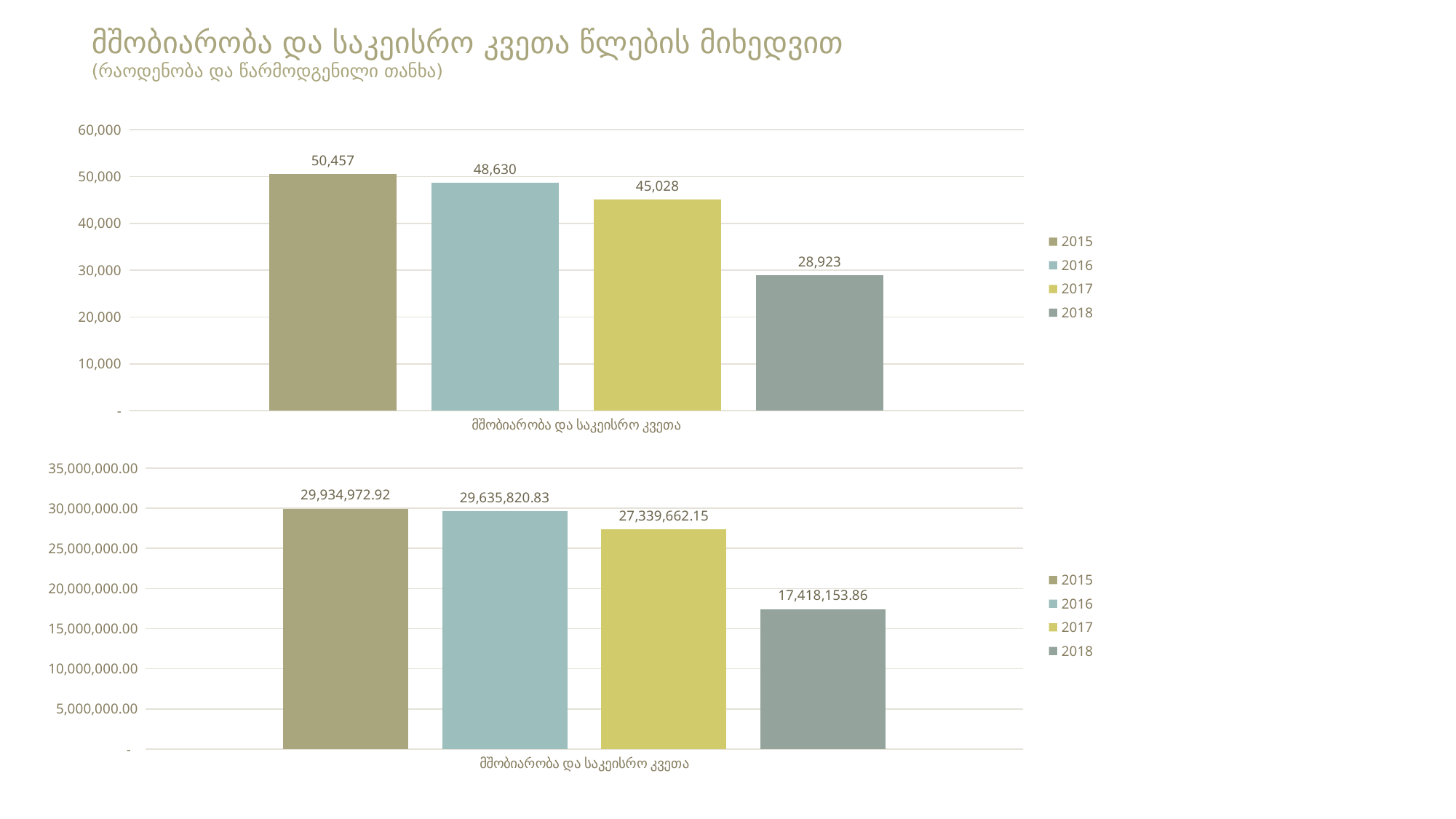
In the bottom chart, do the values rise or fall from 2015 to 2018? fall In the bottom chart, what is the value for 2017? 27,339,662.15 In the top chart, what is the difference between the values for 2015 and 2018? 21,534 In the top chart, what is the value for 2015? 50,457 In the bottom chart, which year has the lowest value? 2018 In the bottom chart, how many series does the legend list? 4 In the bottom chart, what is the value for 2018? 17,418,153.86 In the bottom chart, what is the difference between the values for 2015 and 2016? 299,152.09 In the top chart, which is larger, the value for 2016 or the value for 2017? 2016 In the top chart, which year has the highest value? 2015 What kind of chart is the top chart? bar chart In the top chart, what is the value for 2018? 28,923